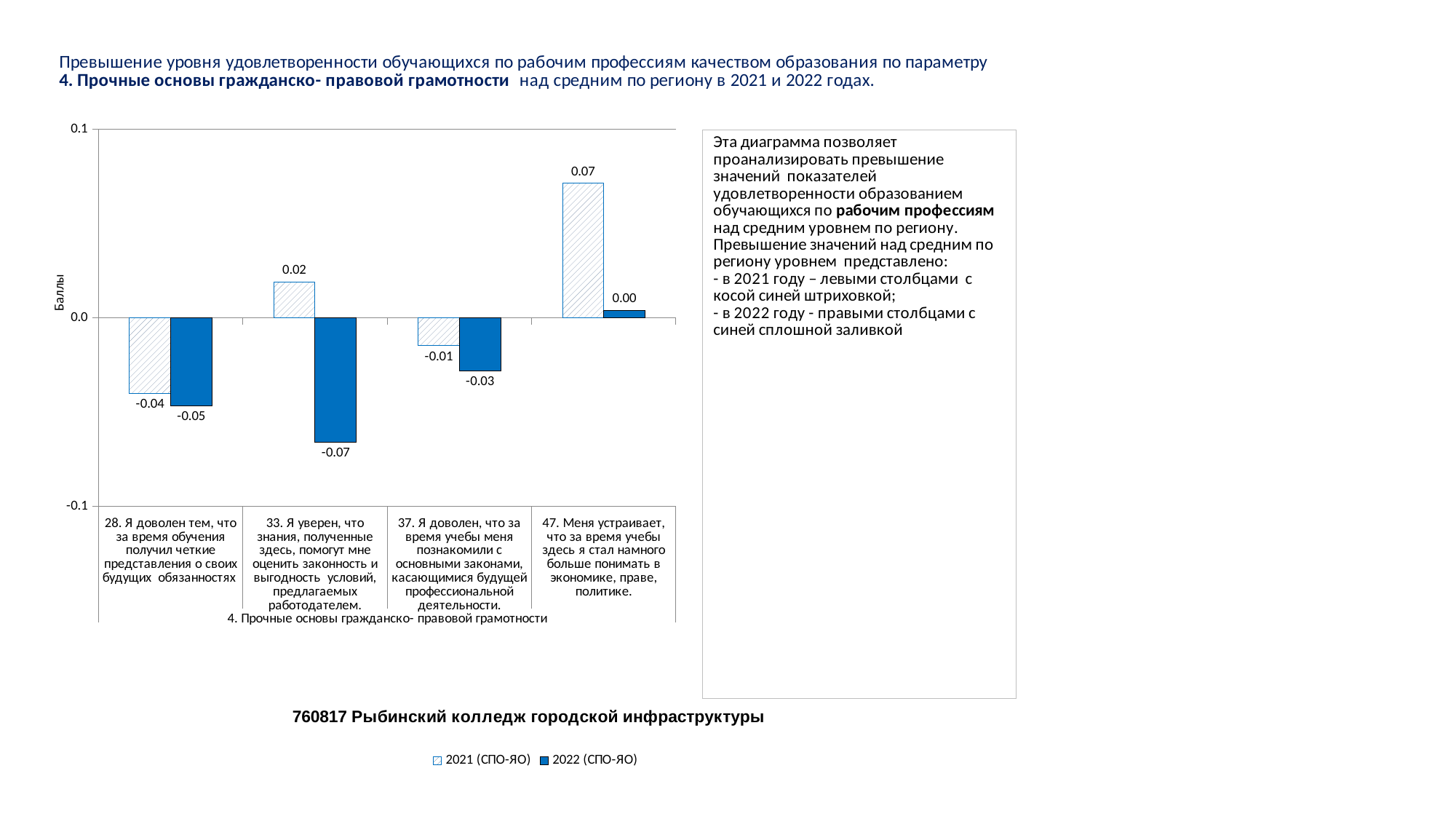
Какое значение больше для категории «28. Я доволен тем, что за время обучения получил четкие представления о своих будущих обязанностях»: 2021 (СПО-ЯО) или 2022 (СПО-ЯО)? 2021 (СПО-ЯО) В какой категории значение серии 2022 (СПО-ЯО) наименьшее? 33. Я уверен, что знания, полученные здесь, помогут мне оценить законность и выгодность условий, предлагаемых работодателем. Сколько категорий показано на диаграмме? 4 Какое значение для категории «28. Я доволен тем, что за время обучения получил четкие представления о своих будущих обязанностях» в серии 2021 (СПО-ЯО)? -0.04 Сколько серий перечислено в легенде диаграммы? 2 Какое значение для категории «47. Меня устраивает, что за время учебы здесь я стал намного больше понимать в экономике, праве, политике.» в серии 2021 (СПО-ЯО)? 0.07 Какова разница между значениями серий 2021 (СПО-ЯО) и 2022 (СПО-ЯО) для категории «33. Я уверен, что знания, полученные здесь, помогут мне оценить законность и выгодность условий, предлагаемых работодателем.»? 0.09 В какой категории значение серии 2021 (СПО-ЯО) наибольшее? 47. Меня устраивает, что за время учебы здесь я стал намного больше понимать в экономике, праве, политике. Какое значение для категории «37. Я доволен, что за время учебы меня познакомили с основными законами, касающимися будущей профессиональной деятельности.» в серии 2022 (СПО-ЯО)? -0.03 Какое значение для категории «33. Я уверен, что знания, полученные здесь, помогут мне оценить законность и выгодность условий, предлагаемых работодателем.» в серии 2022 (СПО-ЯО)? -0.07 Как подписана вертикальная ось диаграммы? Баллы Какого типа эта диаграмма? Столбчатая (bar chart)